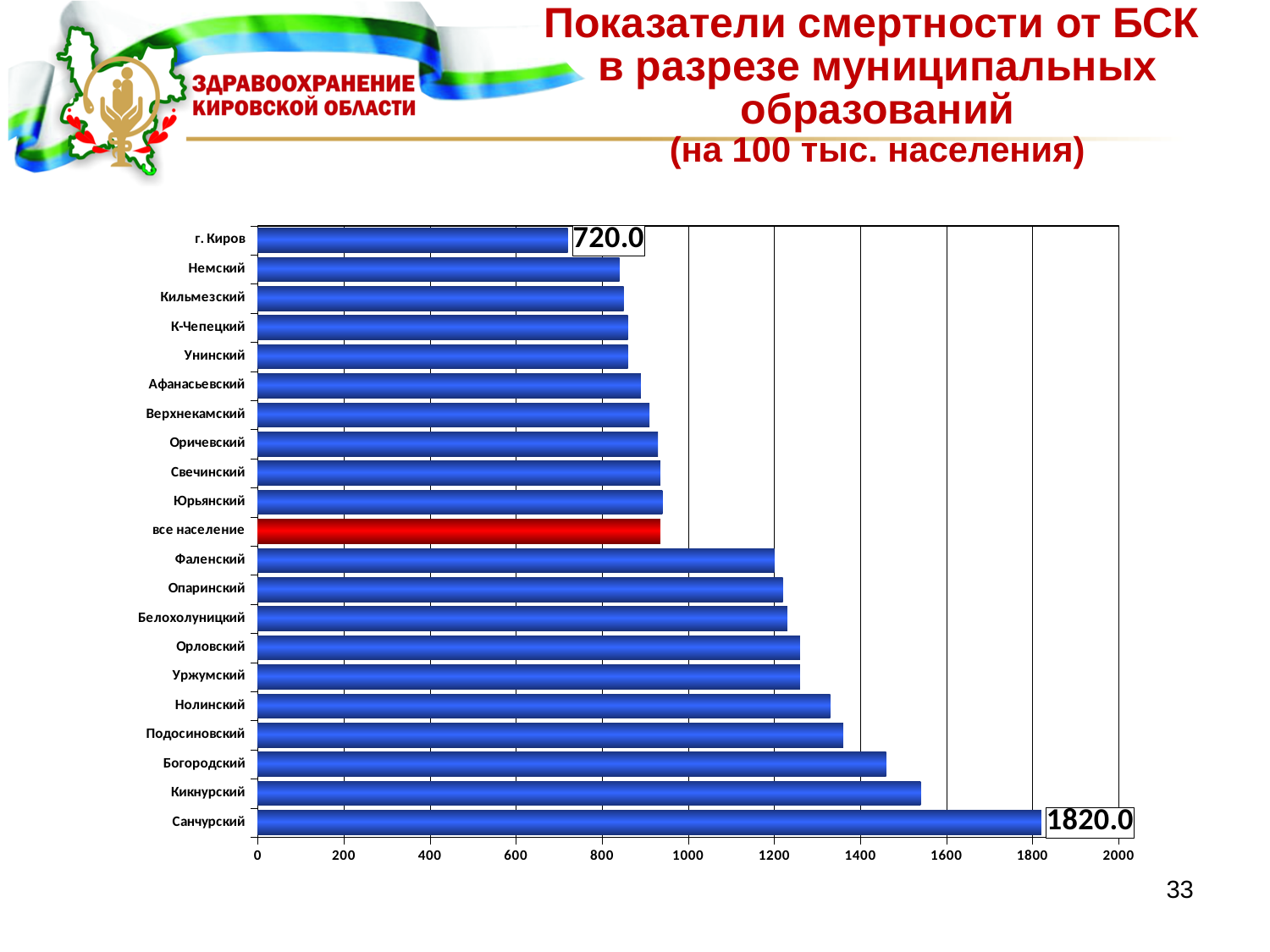
Is the value for все население greater or less than 1000? less How many categories are shown on the chart? 21 Which municipality has the highest mortality rate on the chart? Санчурский What is the value for Санчурский? 1820.0 Which is larger, the value for Кикнурский or the value for Немский? Кикнурский What is the value for г. Киров? 720.0 Which bar on the chart is coloured red? все население What is the difference between the values for Санчурский and г. Киров? 1100.0 What kind of chart is shown on the slide? bar chart Is the value for Кикнурский greater or less than 1400? greater Is the value for Немский greater or less than 800? greater Which category has the lowest value on the chart? г. Киров